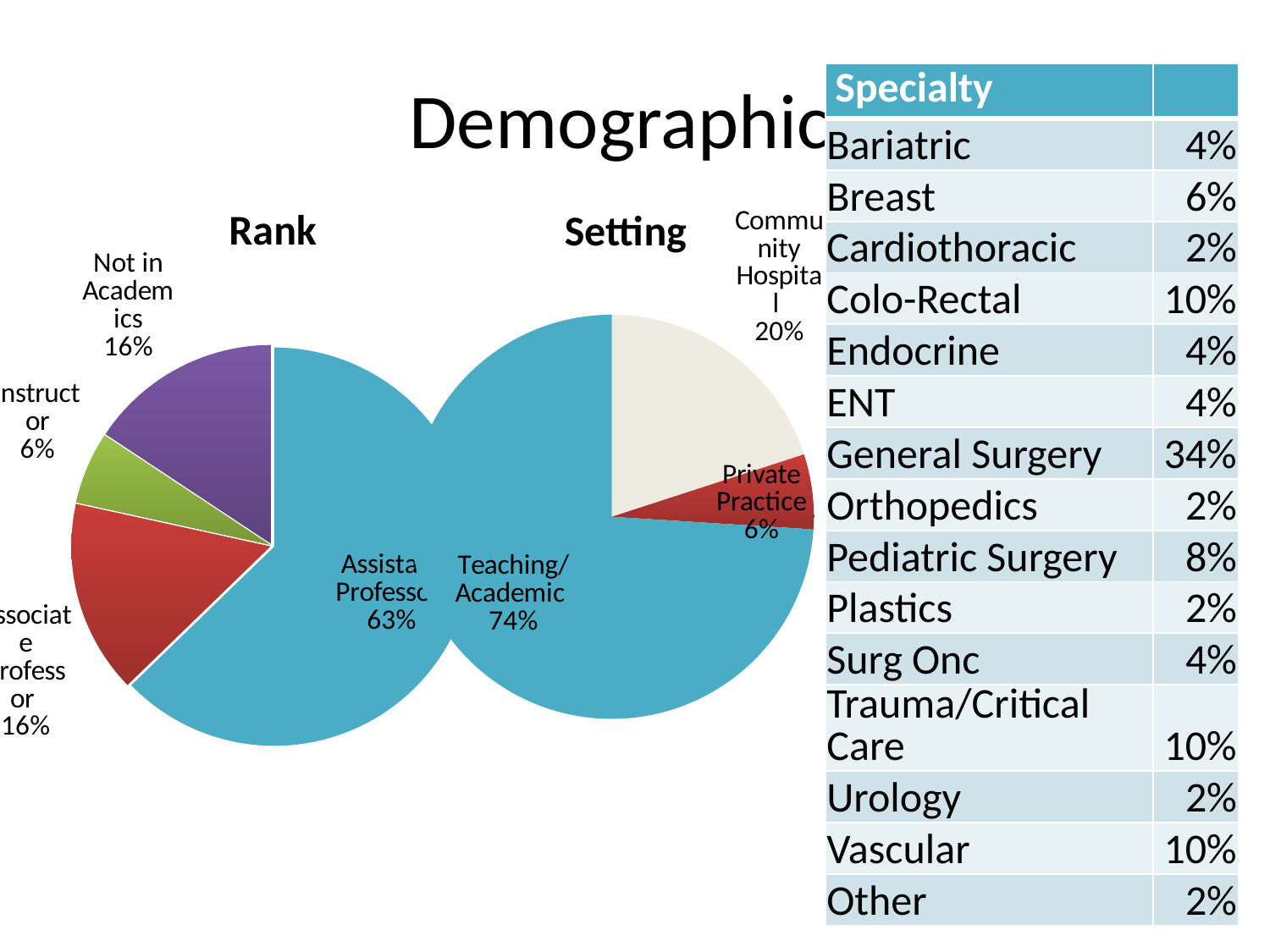
In the Rank chart, which category has the largest share? Assistant Professor In the Rank chart, which category has the smallest share? Instructor In the Setting chart, what is the difference between the Teaching/Academic share and the Community Hospital share? 54% In the Rank chart, what share is Not in Academics? 16% What kind of chart is the Rank chart? pie chart In the Setting chart, what share is Private Practice? 6% In the Setting chart, what share is Community Hospital? 20% In the Setting chart, which is larger, Community Hospital or Private Practice? Community Hospital How many slices does the Rank chart have? 4 How many slices does the Setting chart have? 3